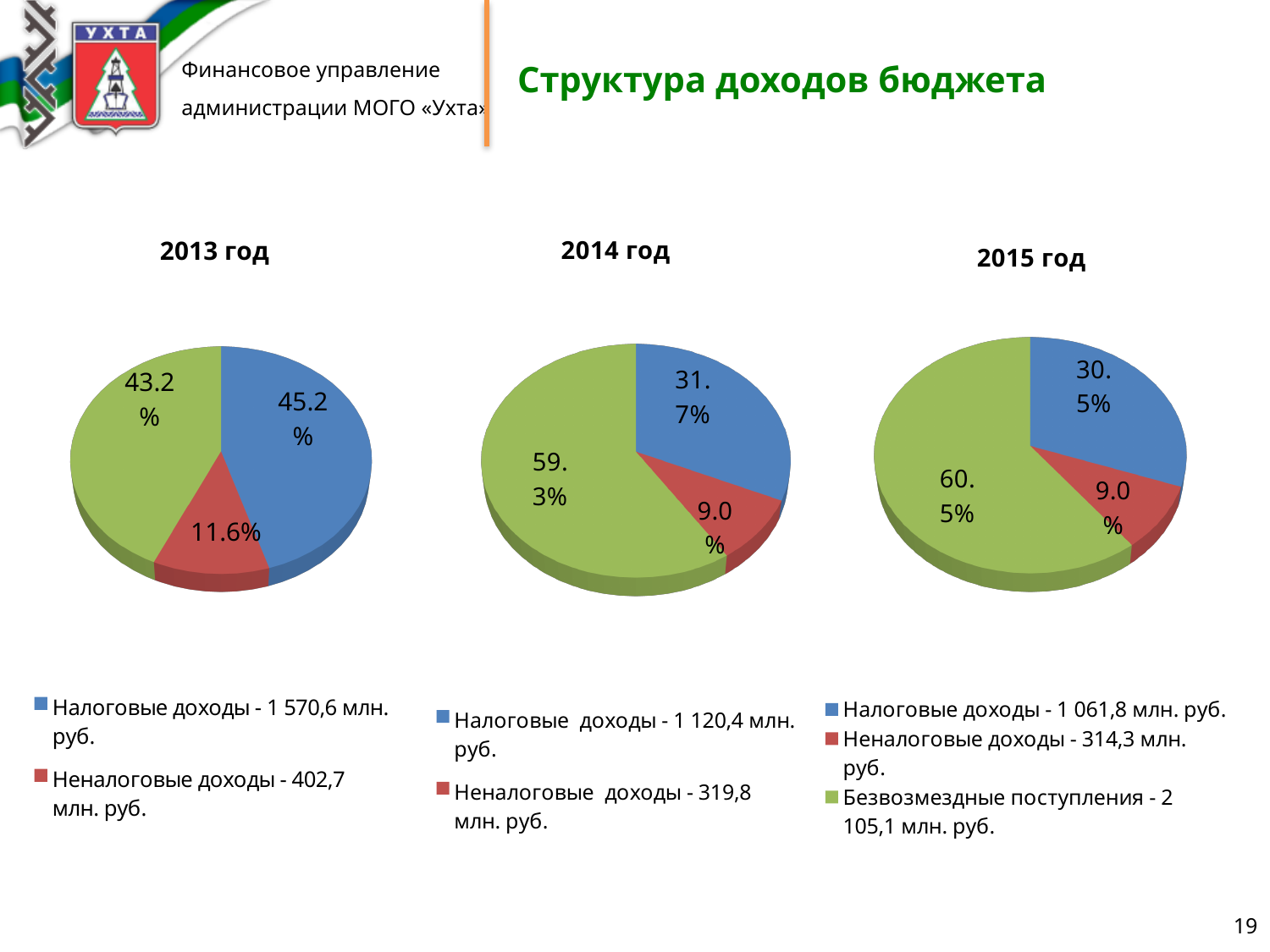
In the 2013 год chart, what share does the green slice have? 43.2% In the 2013 год chart, what share does the red slice (Неналоговые доходы) have? 11.6% What kind of charts are shown on the slide? Pie charts In the 2014 год chart, what share does the green slice have? 59.3% In the 2015 год chart, which slice is the smallest? The red slice (Неналоговые доходы), 9.0% In the 2015 год chart, which slice is the largest? The green slice (Безвозмездные поступления), 60.5% How many slices does each pie chart have? 3 In the 2013 год chart, which is larger: the blue slice or the green slice? The blue slice (45.2%) According to the 2015 год legend, what is the value of Налоговые доходы? 1 061,8 млн. руб. In the 2015 год chart, what is the difference between the green slice (60.5%) and the blue slice (30.5%)? 30.0%